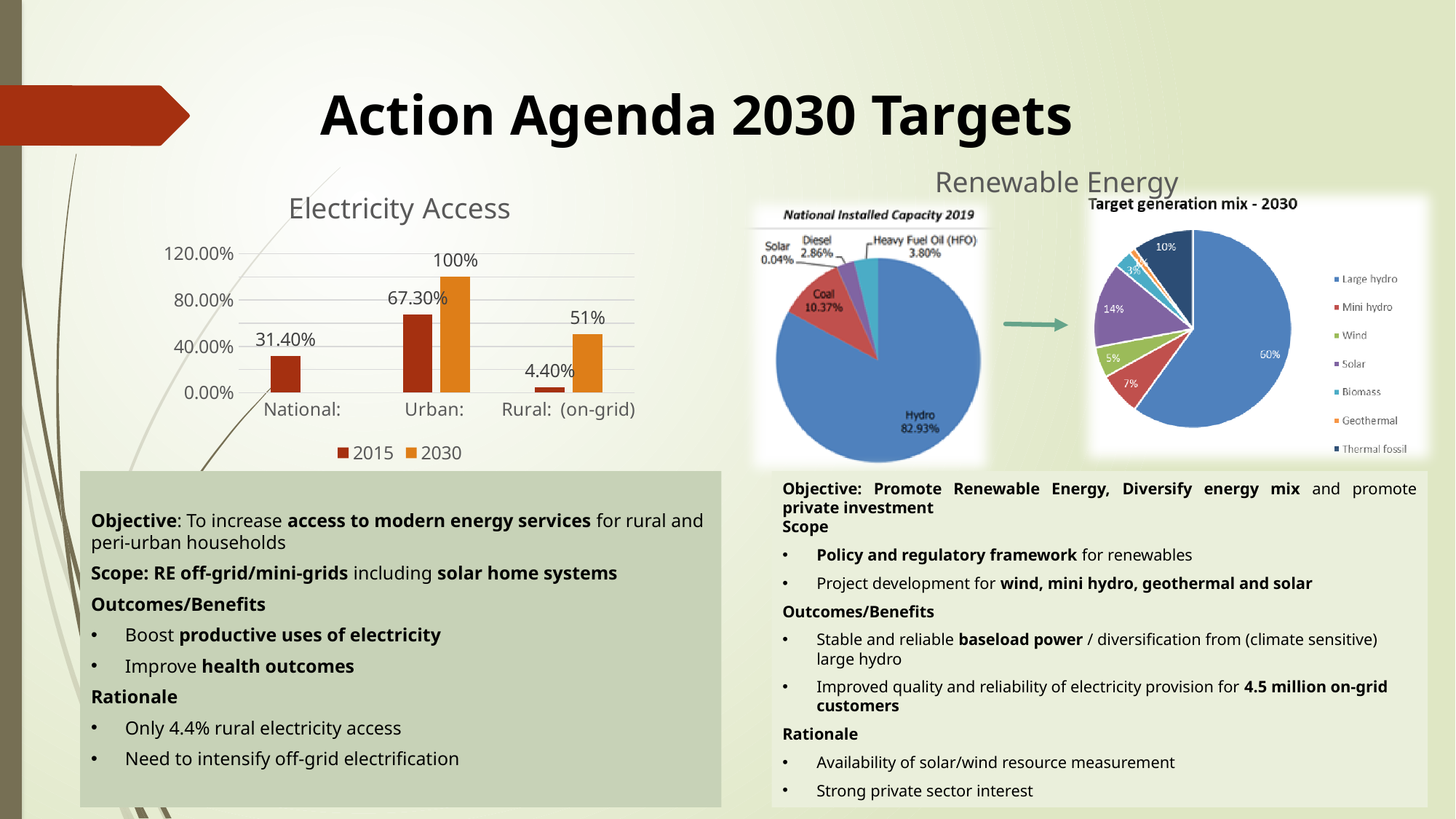
In the Electricity Access chart, which category has the lowest 2015 value? Rural: (on-grid) In the Electricity Access chart, what is the 2015 value for National? 31.40% In the Target generation mix - 2030 chart, how many entries does the legend list? 7 In the National Installed Capacity 2019 chart, what share does Coal have? 10.37% In the Electricity Access chart, what is the difference between the 2030 and 2015 values for Urban? 32.70% In the Electricity Access chart, how many series does the legend list? 2 In the Electricity Access chart, what is the 2015 value for Rural (on-grid)? 4.40% In the Electricity Access chart, what is the 2030 value for Urban? 100% In the Target generation mix - 2030 chart, what share does Large hydro have? 60% What kind of chart is the Electricity Access chart? Bar chart In the National Installed Capacity 2019 chart, what share does Hydro have? 82.93% In the National Installed Capacity 2019 chart, which source has the smallest share? Solar